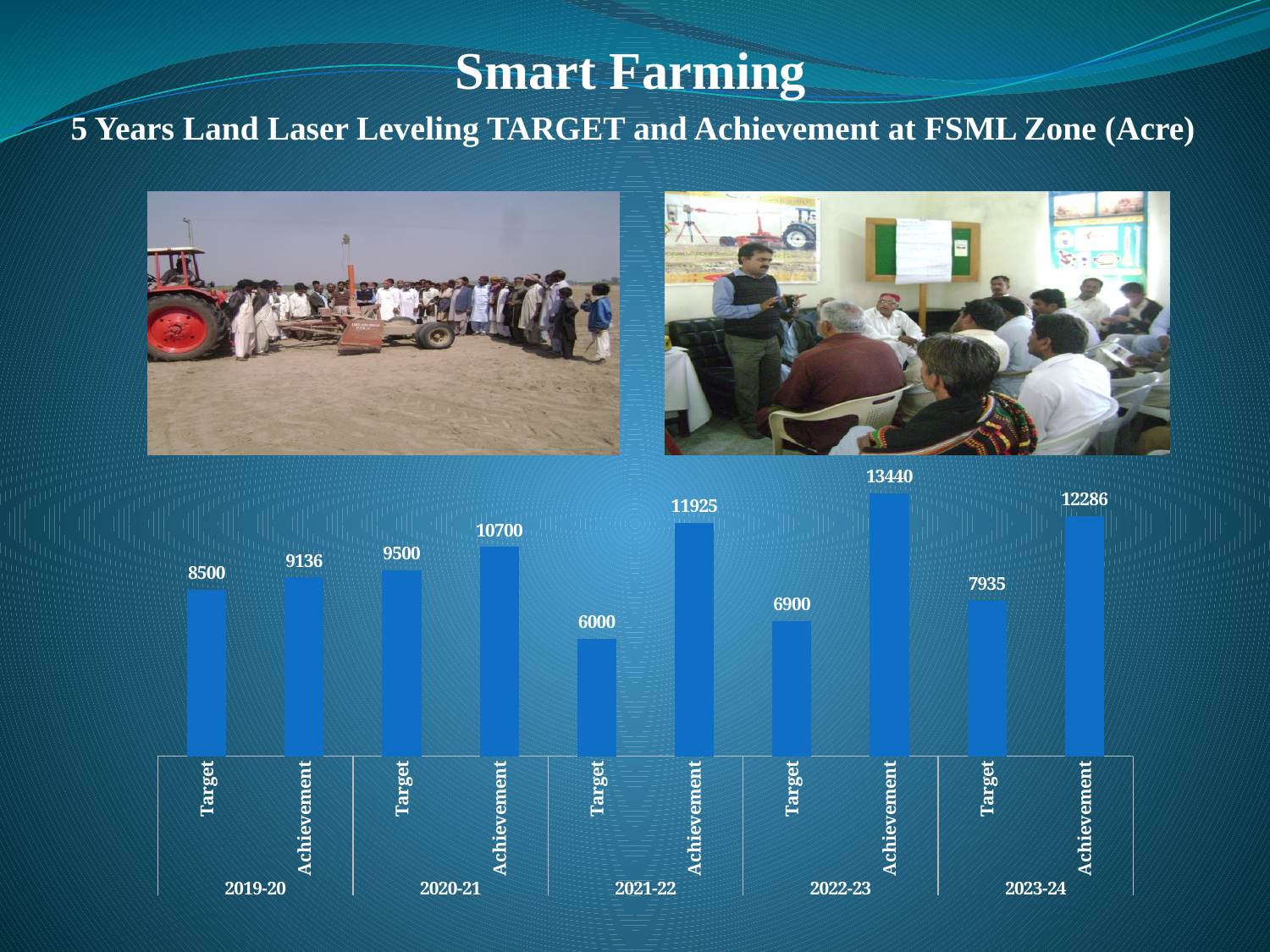
How many bars are plotted in the chart? 10 Which year has the highest Achievement value? 2022-23 Do the Target values rise or fall from 2021-22 to 2023-24? Rise Which year has the lowest Target value? 2021-22 What is the difference between the Target values for 2020-21 and 2019-20? 1000 What kind of chart is shown on the slide? Bar chart What is the Achievement value for 2022-23? 13440 What is the difference between Achievement and Target in 2021-22? 5925 What is the Target value for 2019-20? 8500 What is the Target value for 2021-22? 6000 Which is larger, the Achievement for 2020-21 or the Achievement for 2021-22? Achievement for 2021-22 What is the Achievement value for 2023-24? 12286